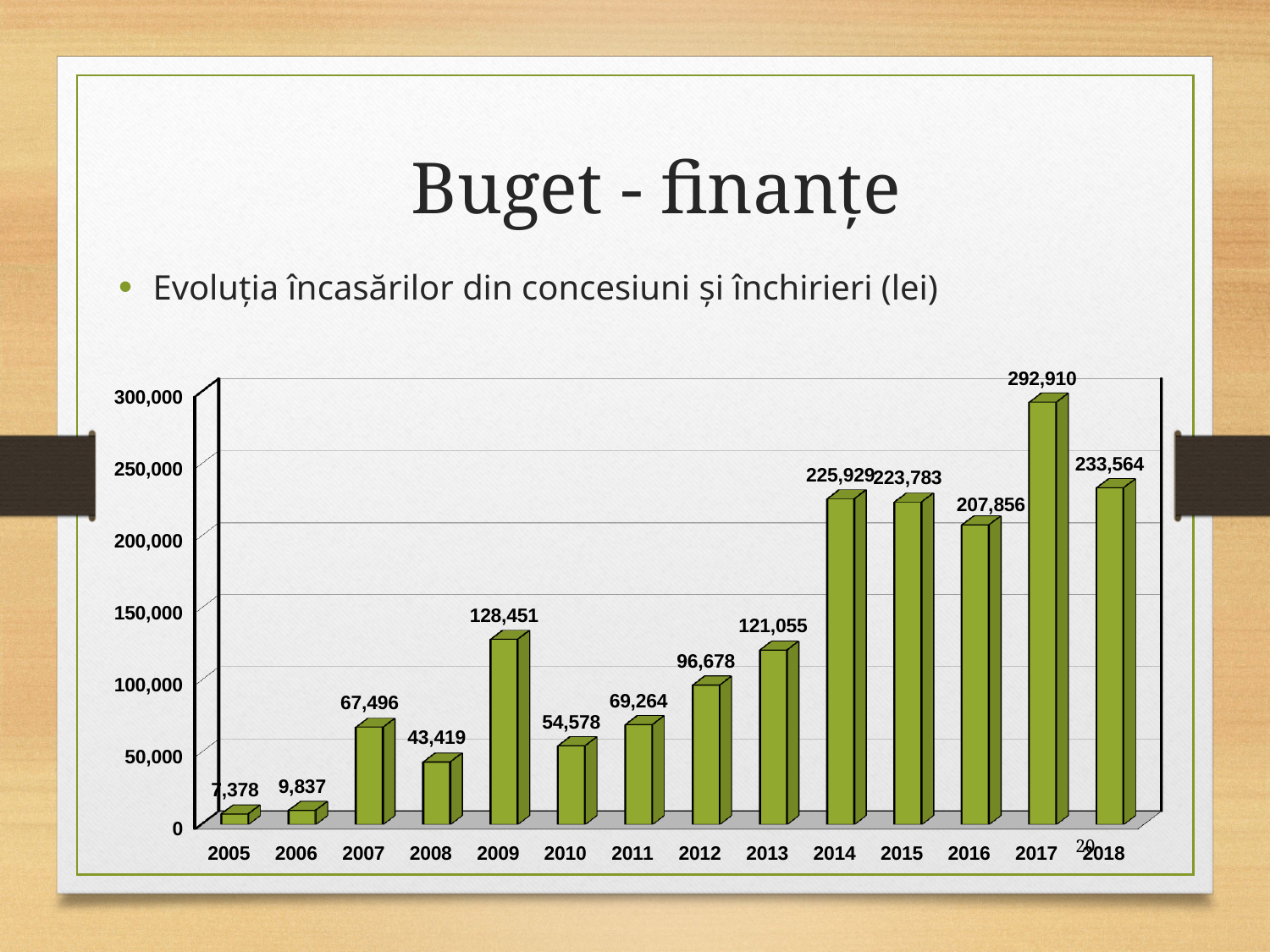
What is the value for 2005? 7,378 How many years are shown on the x axis? 14 Is the value for 2012 greater or less than 100,000? less Which is larger, the value for 2013 or the value for 2016? 2016 What is the difference between the values for 2009 and 2008? 85,032 What is the difference between the values for 2017 and 2018? 59,346 Which year has the highest value? 2017 What is the value for 2017? 292,910 What kind of chart is shown on the slide? bar chart Do the values rise or fall from 2010 to 2014? rise Which year has the lowest value? 2005 What is the value for 2009? 128,451